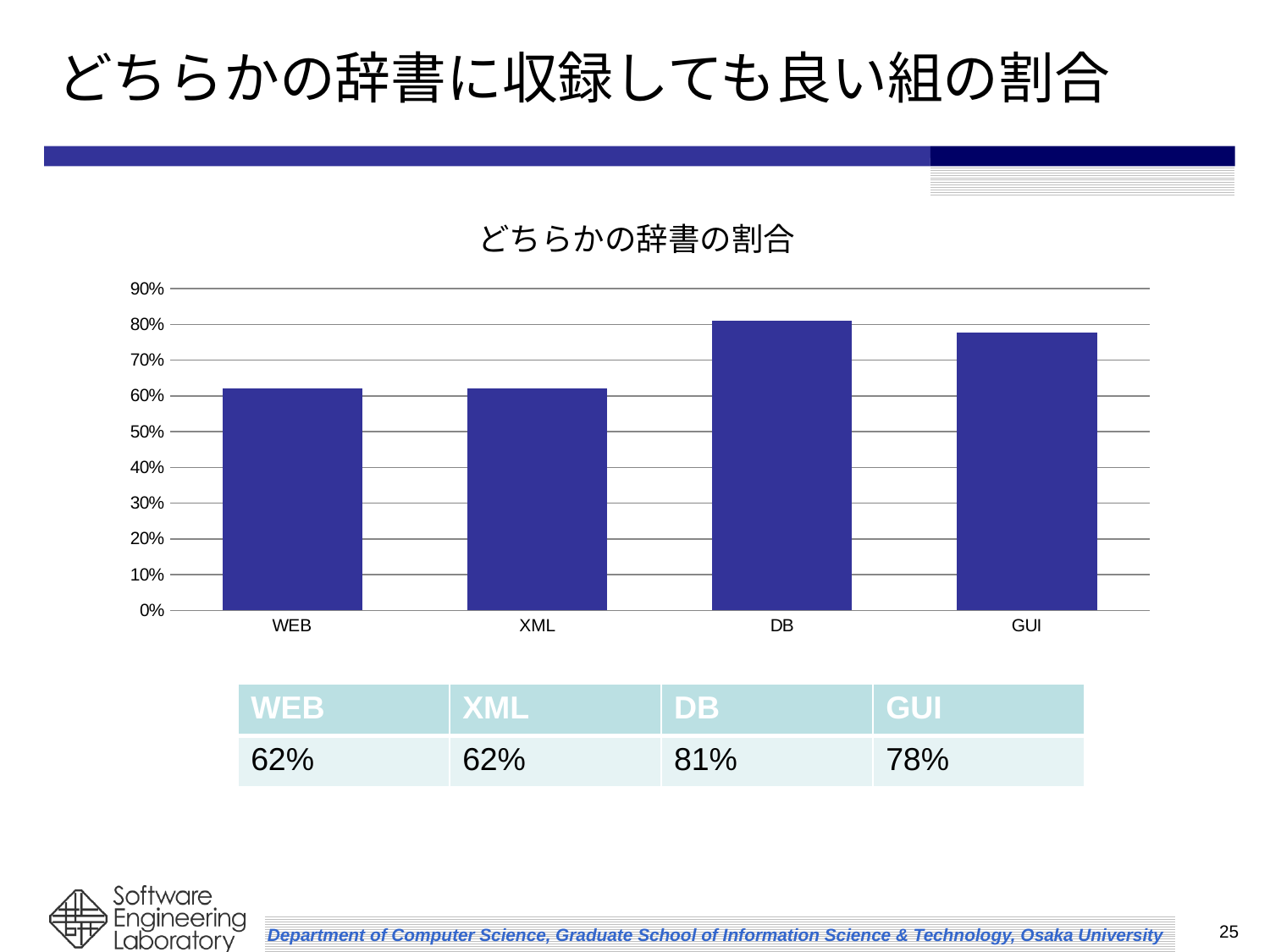
What is the difference between the values for DB and XML? 19% What is the value for WEB? 62% Is the value for WEB greater or less than 70%? less What is the difference between the values for DB and GUI? 3% What is the title of the chart? どちらかの辞書の割合 What type of chart is shown on the slide? bar chart Which is larger, the value for GUI or the value for XML? GUI Which category has the highest value? DB What is the value for GUI? 78% What is the value for DB? 81% Is the value for DB greater or less than 80%? greater How many categories are plotted in the chart? 4